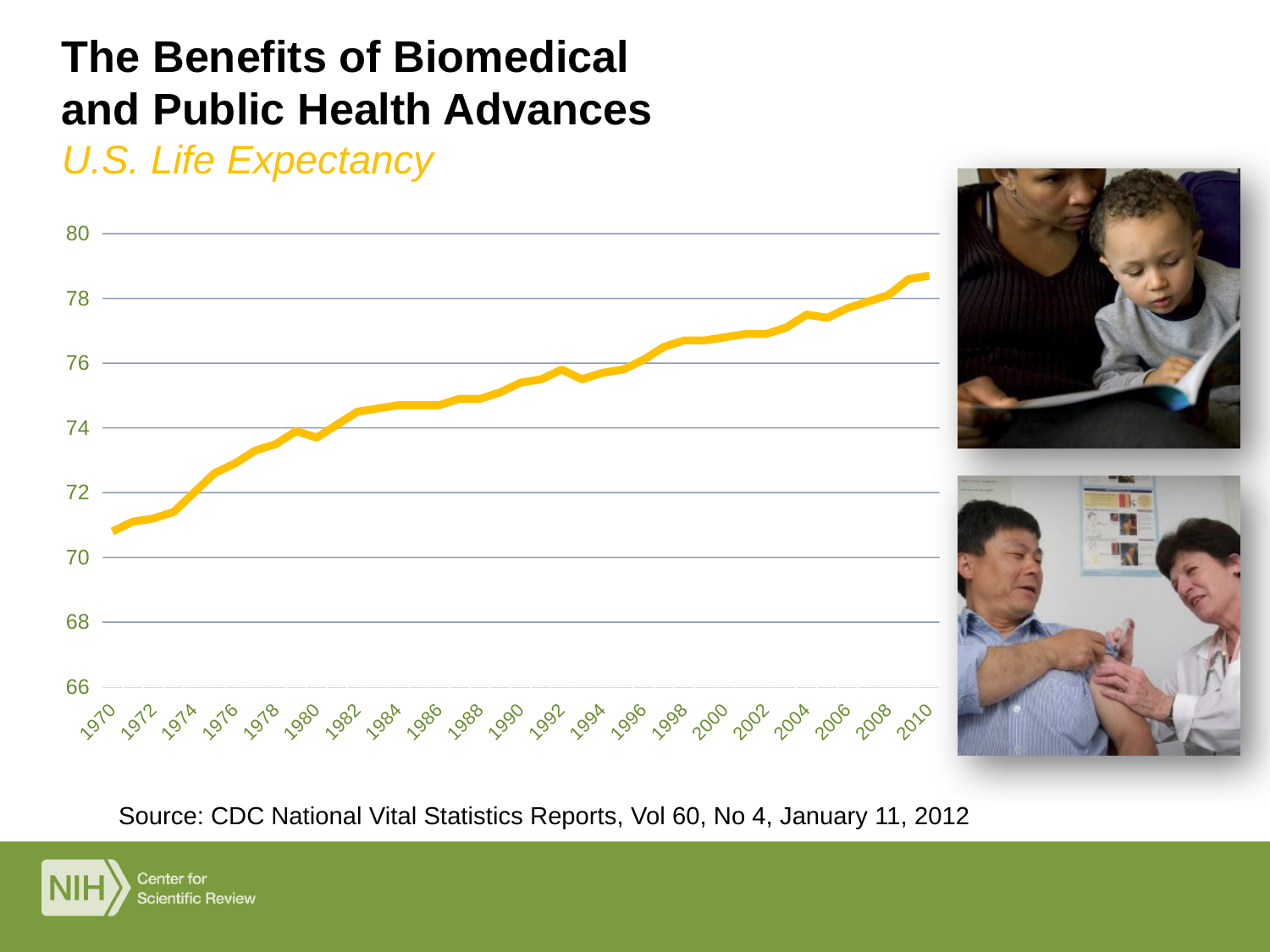
What is the title of the chart? U.S. Life Expectancy Is the value for 1976 greater or less than 74? less Is the value for 1970 greater or less than 72? less Is the value for 2000 greater or less than 76? greater What colour is the line in the chart? yellow Do the values generally rise or fall from 1970 to 2010? rise Which year has the larger value, 1990 or 2000? 2000 What kind of chart is shown on the slide? line chart Which year has the lowest life expectancy value on the chart? 1970 Which year has the highest life expectancy value on the chart? 2010